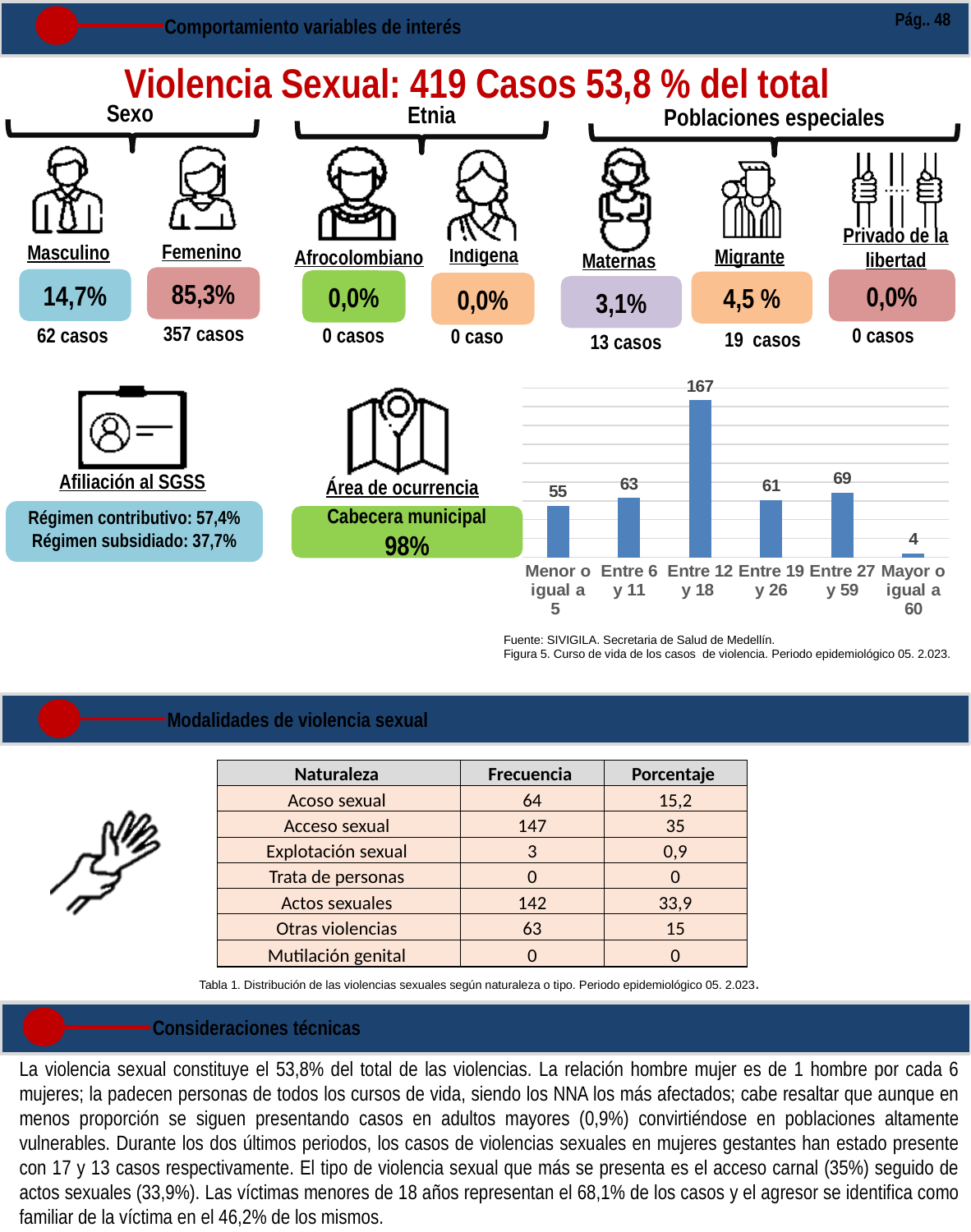
In the bar chart of cases by life stage (Figura 5), which is larger: the value for 'Entre 27 y 59' or the value for 'Entre 19 y 26'? Entre 27 y 59 In the bar chart of cases by life stage (Figura 5), how many categories are shown on the x axis? 6 In the bar chart of cases by life stage (Figura 5), what is the value for 'Entre 12 y 18'? 167 What kind of chart is Figura 5 (cases by life stage)? Bar chart In the bar chart of cases by life stage (Figura 5), what is the value for 'Entre 27 y 59'? 69 In the bar chart of cases by life stage (Figura 5), which category has the highest value? Entre 12 y 18 According to the caption, what is the source of the bar chart (Figura 5)? SIVIGILA. Secretaria de Salud de Medellín In the bar chart of cases by life stage (Figura 5), what is the value for 'Menor o igual a 5'? 55 In the bar chart of cases by life stage (Figura 5), which category has the lowest value? Mayor o igual a 60 In the bar chart of cases by life stage (Figura 5), what is the value for 'Mayor o igual a 60'? 4 In the bar chart of cases by life stage (Figura 5), what is the difference between the values for 'Entre 6 y 11' and 'Entre 19 y 26'? 2 In the bar chart of cases by life stage (Figura 5), what is the difference between the values for 'Entre 12 y 18' and 'Entre 6 y 11'? 104